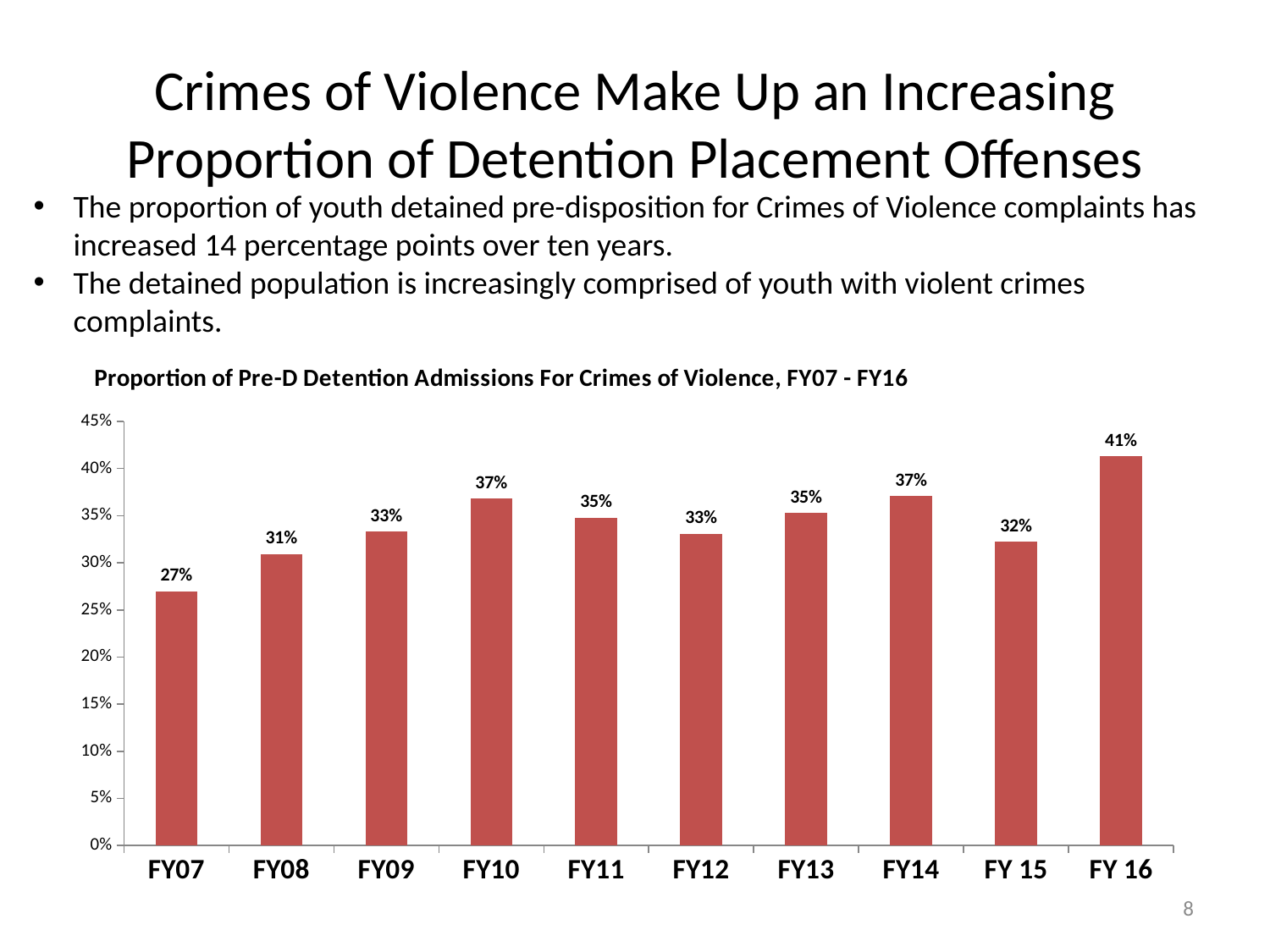
Which fiscal year has the highest proportion? FY 16 Overall, do the values rise or fall from FY07 to FY 16? Rise What is the value for FY 15? 32% What is the value for FY 16? 41% What is the title of the chart? Proportion of Pre-D Detention Admissions For Crimes of Violence, FY07 - FY16 Is the value for FY08 greater or less than 30%? greater How many fiscal years are shown on the x axis? 10 What kind of chart is shown on the slide? Bar chart What is the difference between the values for FY 16 and FY07? 14 percentage points Which is larger, the value for FY10 or the value for FY 15? FY10 Which fiscal year has the lowest proportion? FY07 What is the value for FY07? 27%